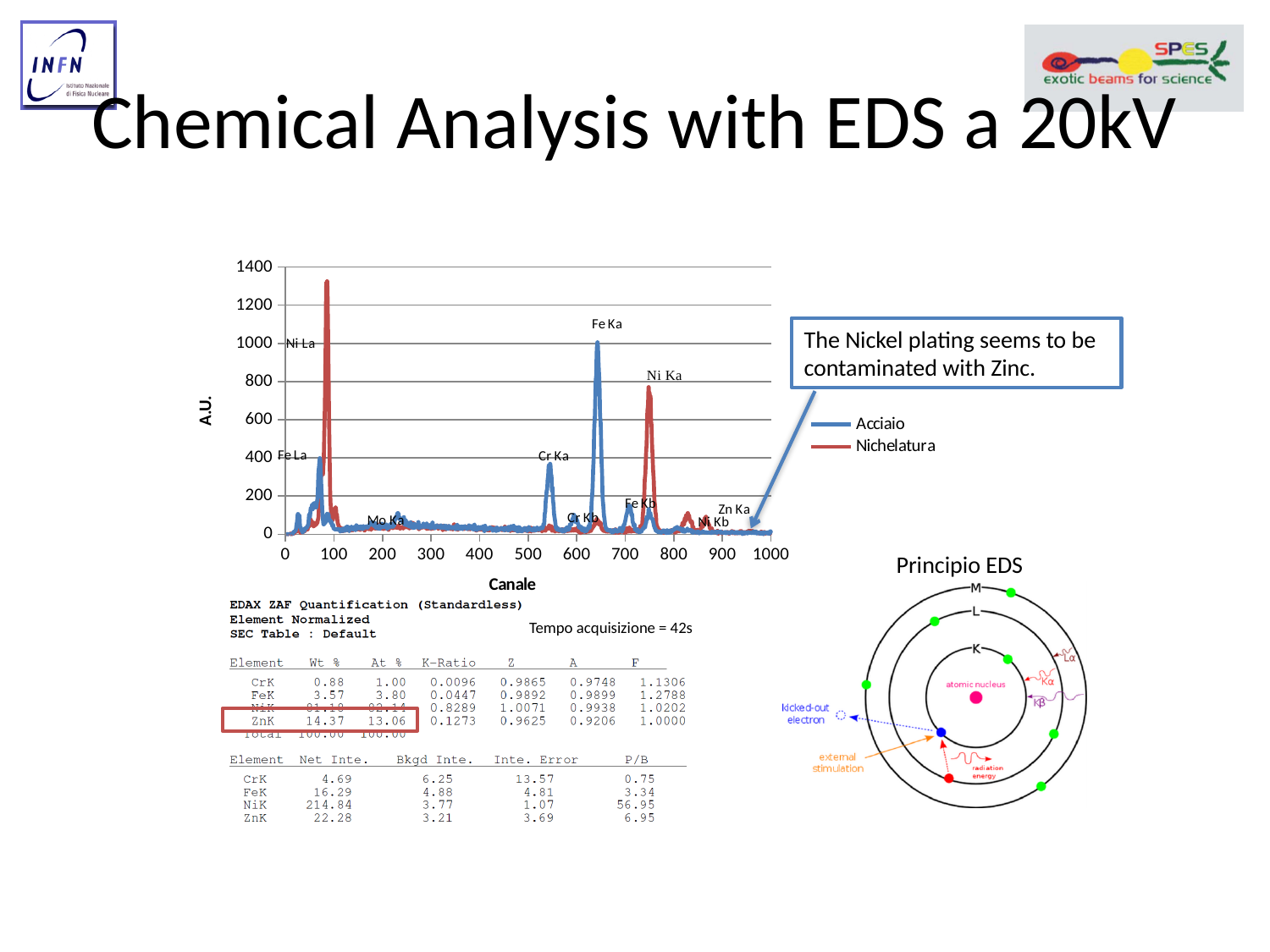
What kind of chart is shown on the slide? line chart Which is higher: the Ni La peak of the Nichelatura series or the Fe Ka peak of the Acciaio series? Ni La peak of Nichelatura Is the peak of the Acciaio series labeled Cr Ka greater or less than 600? less Which series reaches the highest peak in the chart? Nichelatura Is the peak of the Nichelatura series labeled Ni Ka greater or less than 600? greater Is the peak of the Nichelatura series labeled Ni La greater or less than 1200? greater Which is higher: the Fe Ka peak of the Acciaio series or the Ni Ka peak of the Nichelatura series? Fe Ka peak of Acciaio What is the highest value shown on the y axis of the chart? 1400 How many series does the chart legend list? 2 What are the two series named in the chart legend? Acciaio and Nichelatura What is the title of the x axis of the chart? Canale